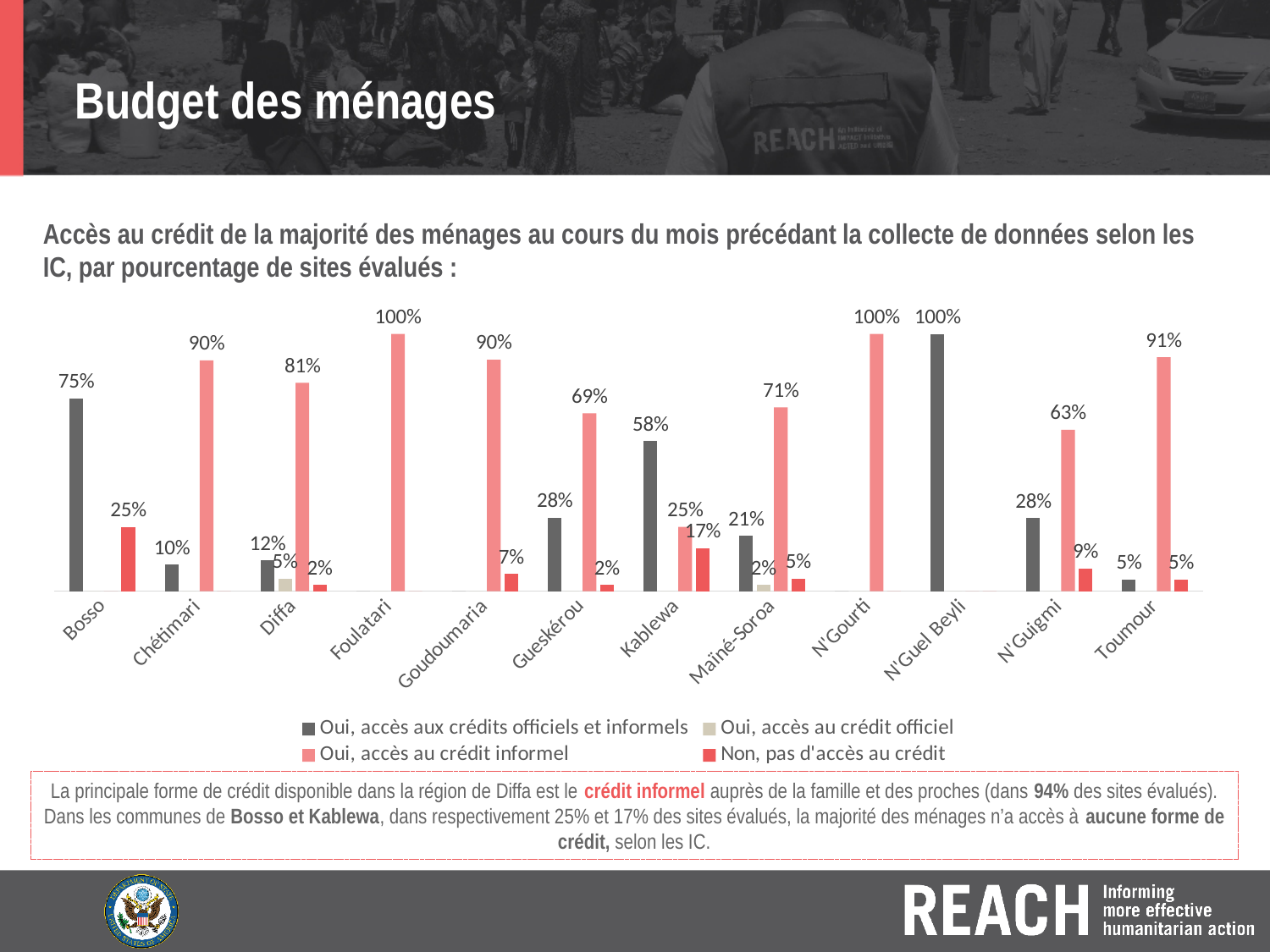
Which is larger: the 'Oui, accès au crédit informel' value for Gueskérou or for Maïné-Soroa? Maïné-Soroa What type of chart is shown on the slide? bar chart What is the value for 'Oui, accès au crédit informel' in Toumour? 91% How many communes (categories) are shown on the x axis of the chart? 12 Which legend entry is represented by the dark grey bars? Oui, accès aux crédits officiels et informels Which commune has the highest value for 'Non, pas d'accès au crédit'? Bosso What is the difference between the 'Oui, accès au crédit informel' values for Chétimari and N'Guigmi? 27% What is the value for 'Oui, accès aux crédits officiels et informels' in Bosso? 75% Which commune has the highest value for 'Oui, accès aux crédits officiels et informels'? N'Guel Beyli How many series does the chart legend list? 4 What is the value for 'Oui, accès au crédit officiel' in Diffa? 5% What is the value for 'Non, pas d'accès au crédit' in Kablewa? 17%